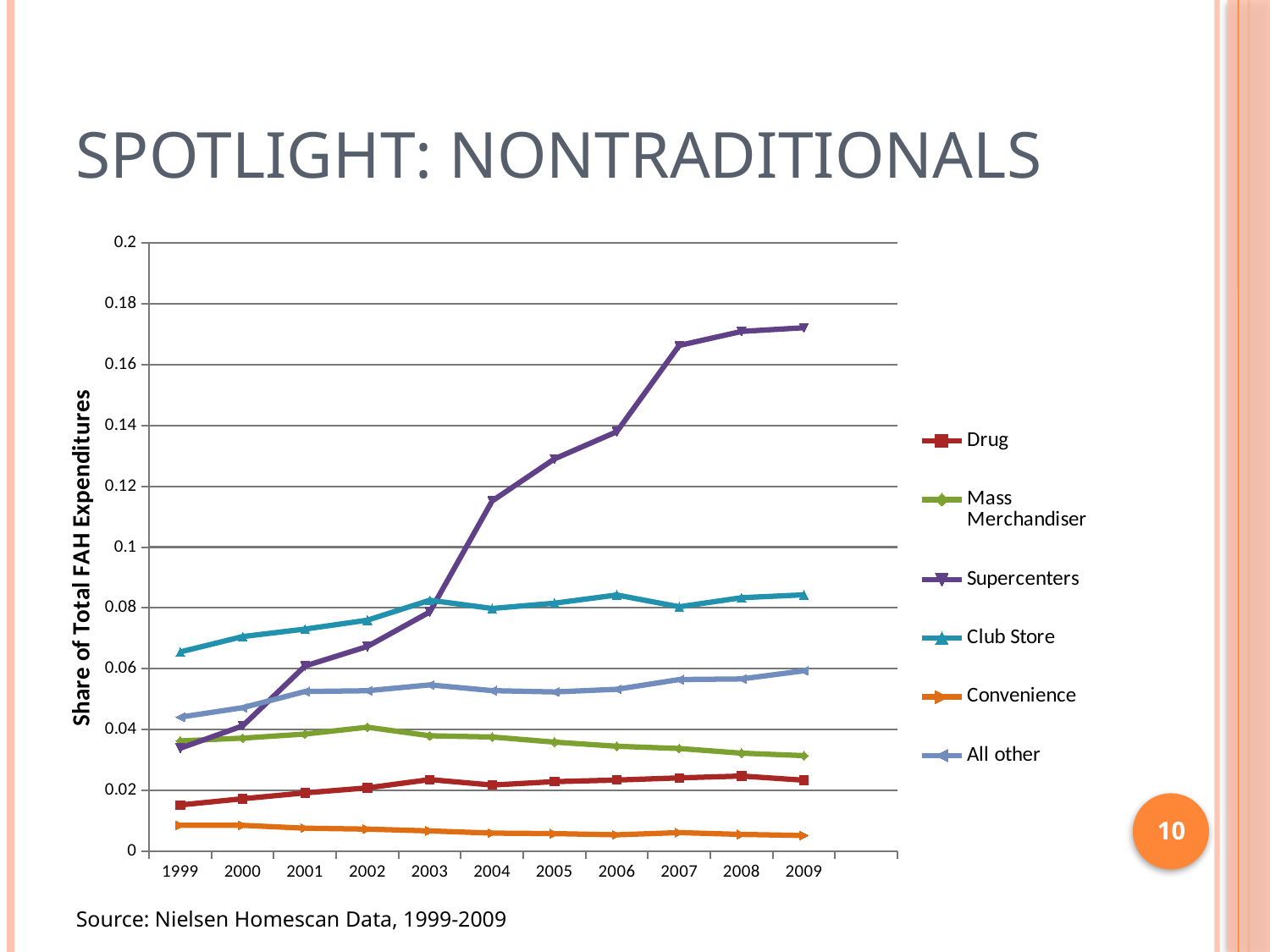
How many series does the legend list? 6 Is the value for Supercenters in 2009 greater or less than 0.16? greater How many years are shown along the x axis? 11 Does the Convenience series rise or fall from 1999 to 2009? fall What is the title of the y axis? Share of Total FAH Expenditures In 2004, which is larger: Supercenters or Club Store? Supercenters Which series has the lowest share in 2009? Convenience What kind of chart is shown on the slide? line chart Does the Supercenters series rise or fall from 1999 to 2009? rise Which series has the highest share in 1999? Club Store Is the value for Mass Merchandiser in 2009 greater or less than 0.04? less Which series has the highest share in 2009? Supercenters